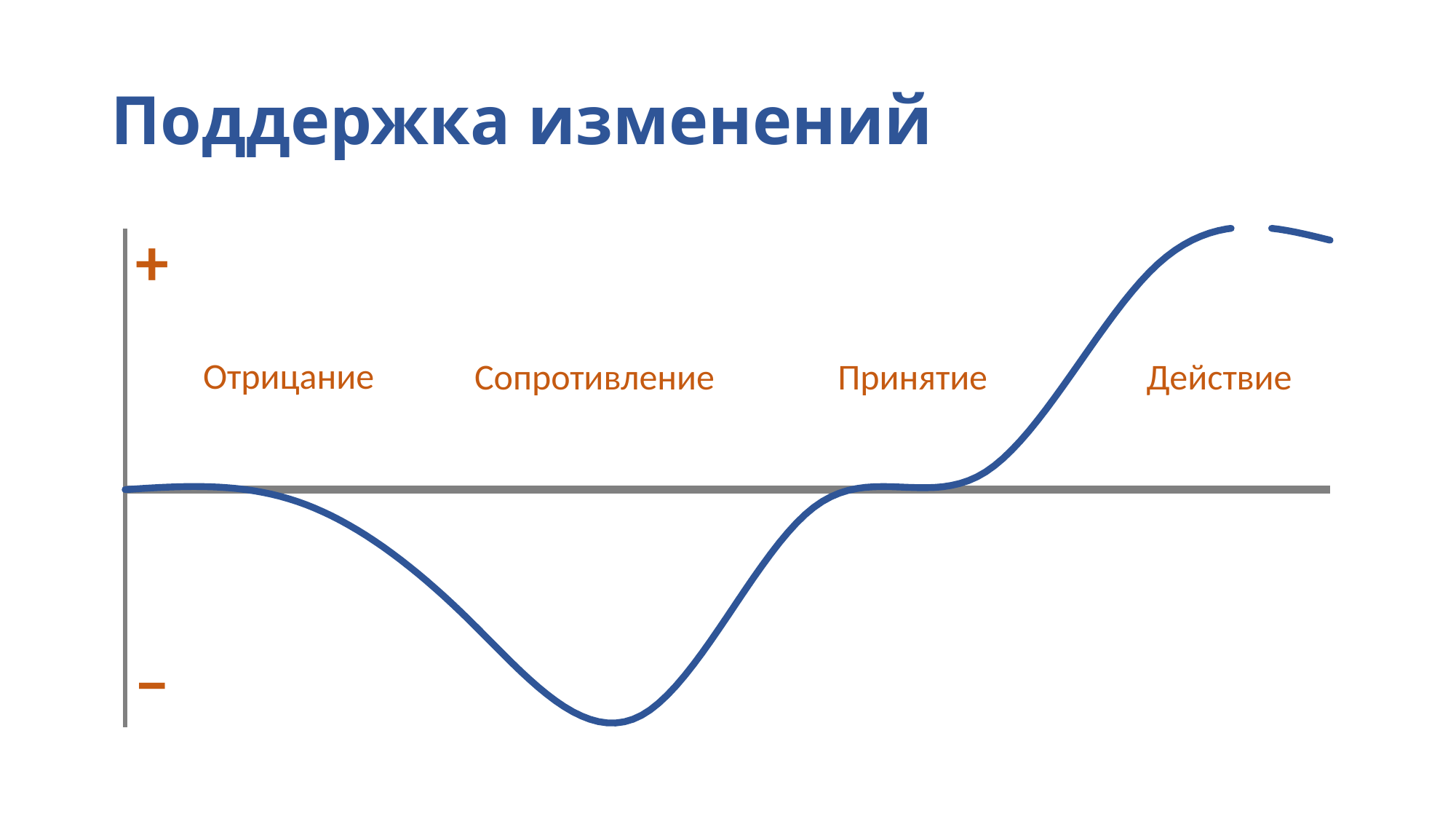
In which stage does the curve reach its highest point? Действие Does the curve rise or fall during the Действие stage? rise Does the curve rise or fall during the Отрицание stage? fall What kind of chart is shown on the slide? line chart How many stages are labelled along the curve? 4 Is the curve above or below the horizontal axis during the Сопротивление stage? below Which stage has the lower curve value: Отрицание or Сопротивление? Сопротивление Which stage has the higher curve value: Сопротивление or Действие? Действие In which stage does the curve reach its lowest point? Сопротивление Is the curve above or below the horizontal axis at the end of the Действие stage? above What are the four stages labelled along the curve, from left to right? Отрицание, Сопротивление, Принятие, Действие What is the title of the slide? Поддержка изменений